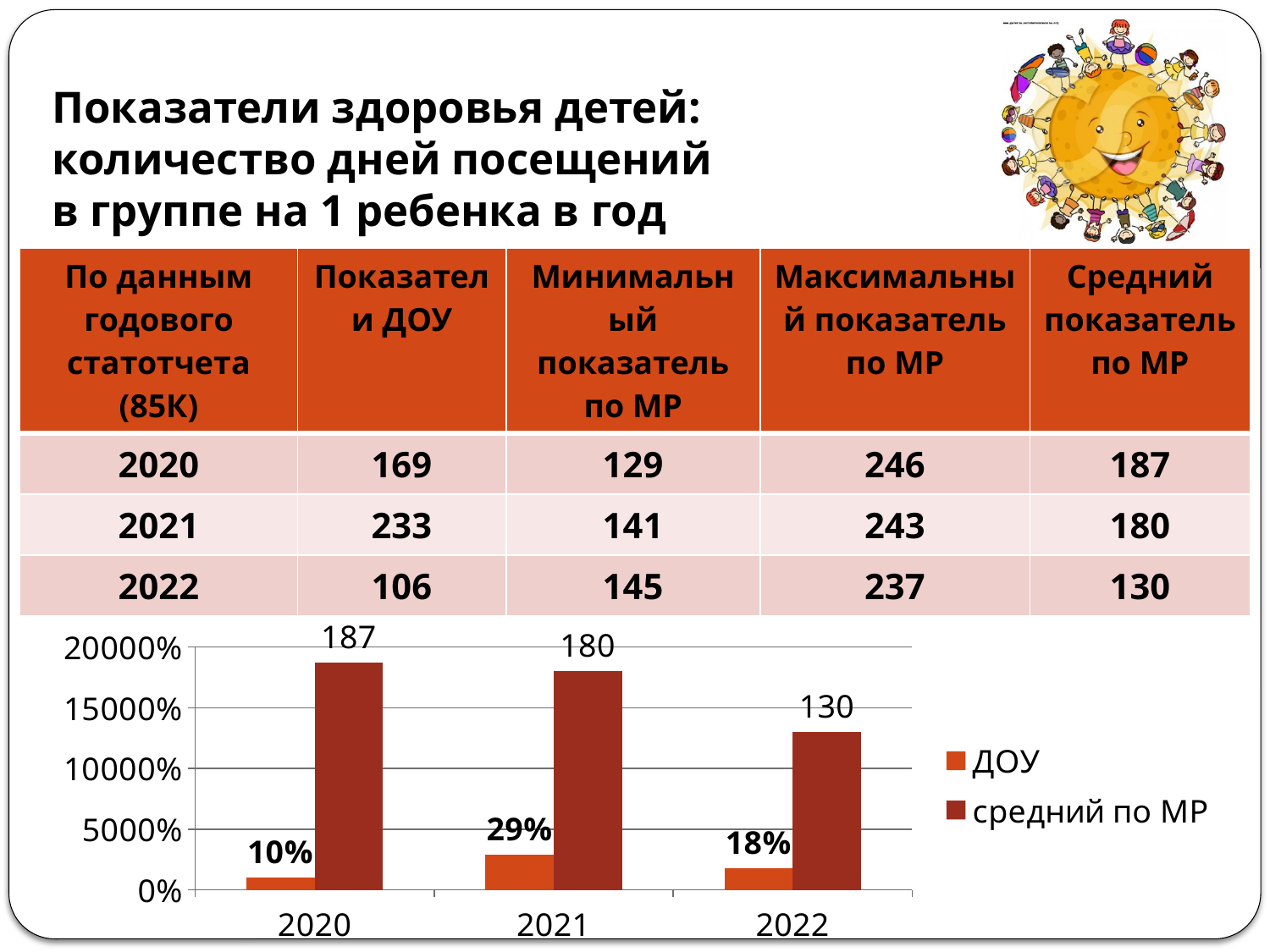
What value is labelled for средний по МР in 2022 in the bar chart? 130 In which year is the средний по МР bar highest? 2020 In which year is the ДОУ bar lowest? 2020 Do the средний по МР values rise or fall from 2020 to 2022? fall What value is labelled for средний по МР in 2020 in the bar chart? 187 Which is larger: the ДОУ value for 2021 or for 2022? 2021 What value is labelled for ДОУ in 2022 in the bar chart? 18% How many series does the legend of the bar chart list? 2 What value is labelled for ДОУ in 2021 in the bar chart? 29% How many years are shown on the x axis of the bar chart? 3 What is the difference between the средний по МР values for 2020 and 2022? 57 Is the средний по МР bar for 2022 greater or less than 15000% on the axis? less